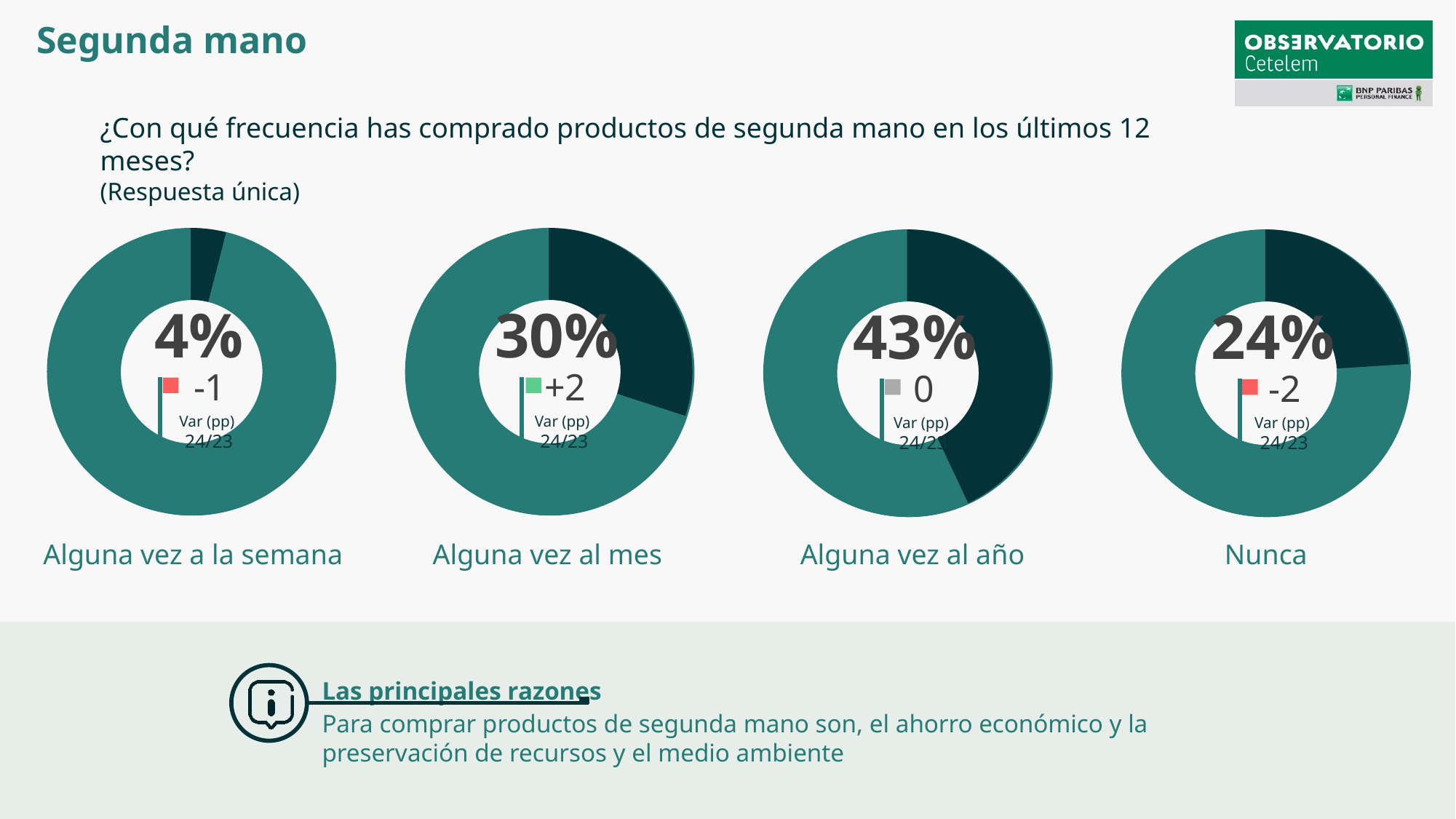
What is the Var (pp) 24/23 value shown in the "Alguna vez al año" donut chart? 0 What percentage is shown in the donut chart labelled "Nunca"? 24% What percentage is shown in the donut chart labelled "Alguna vez al mes"? 30% What percentage is shown in the donut chart labelled "Alguna vez al año"? 43% Which of the four donut charts shows the highest percentage? Alguna vez al año What is the Var (pp) 24/23 value shown in the "Nunca" donut chart? -2 Which of the four donut charts shows the lowest percentage? Alguna vez a la semana What is the difference in percentage points between the "Alguna vez al año" chart and the "Alguna vez al mes" chart? 13 What is the Var (pp) 24/23 value shown in the "Alguna vez al mes" donut chart? +2 How many donut charts are shown on the slide? 4 What percentage is shown in the donut chart labelled "Alguna vez a la semana"? 4% Which shows a larger percentage, the "Nunca" chart or the "Alguna vez al mes" chart? Alguna vez al mes